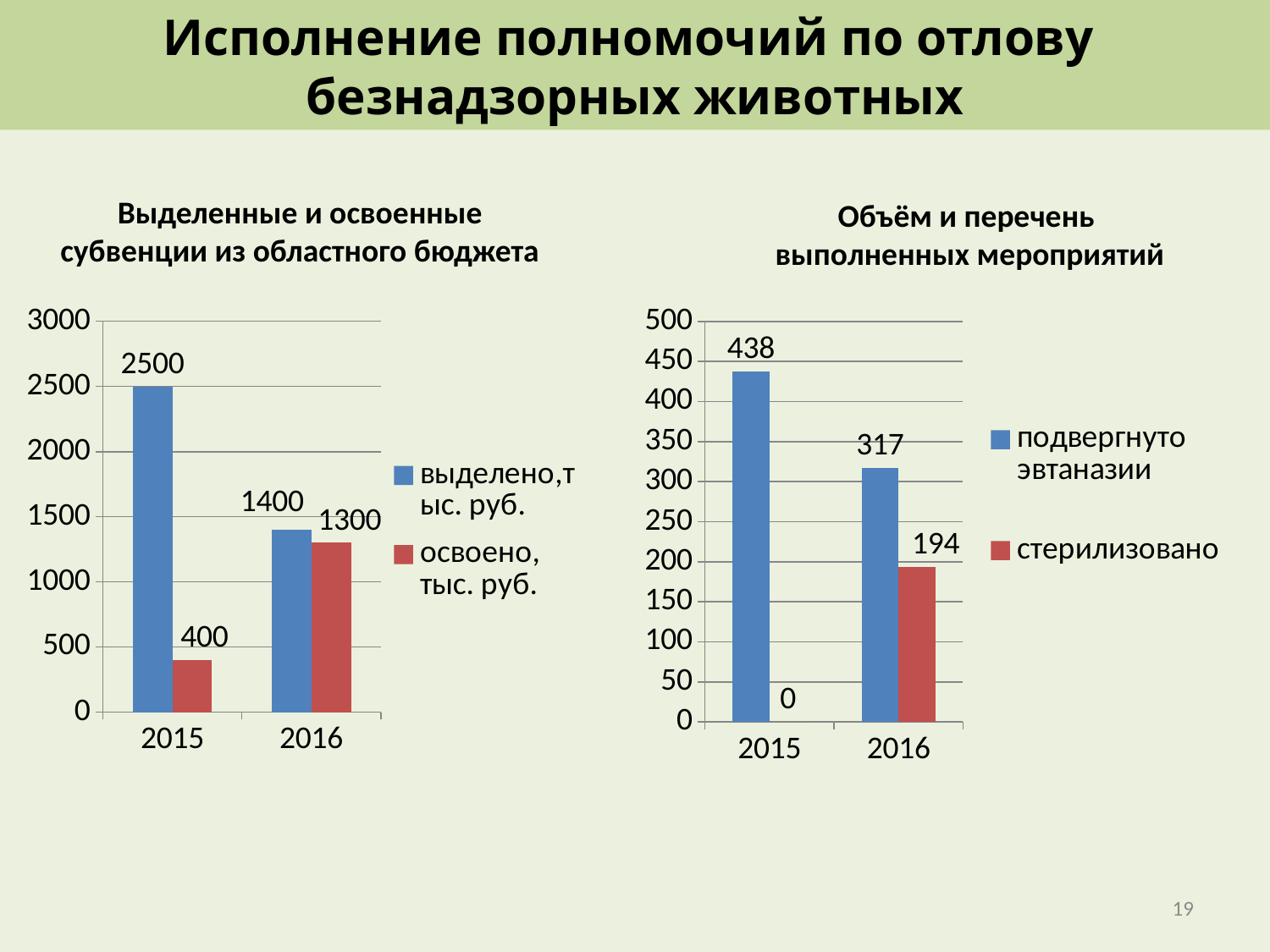
What type of chart is the right chart (Объём и перечень выполненных мероприятий)? bar chart In the left chart (Выделенные и освоенные субвенции из областного бюджета), how many series does the legend list? 2 In the right chart (Объём и перечень выполненных мероприятий), which series has the highest value overall? подвергнуто эвтаназии In the right chart (Объём и перечень выполненных мероприятий), what is the value of подвергнуто эвтаназии for 2015? 438 In the right chart (Объём и перечень выполненных мероприятий), what is the value of стерилизовано for 2016? 194 In the left chart (Выделенные и освоенные субвенции из областного бюджета), does the value of выделено rise or fall from 2015 to 2016? fall In the left chart (Выделенные и освоенные субвенции из областного бюджета), what is the difference between выделено and освоено in 2015? 2100 In the right chart (Объём и перечень выполненных мероприятий), what is the value of стерилизовано for 2015? 0 In the left chart (Выделенные и освоенные субвенции из областного бюджета), what is the value of освоено, тыс. руб. for 2016? 1300 In the right chart (Объём и перечень выполненных мероприятий), what is the difference between подвергнуто эвтаназии in 2015 and 2016? 121 In the left chart (Выделенные и освоенные субвенции из областного бюджета), which year has the higher value of освоено, тыс. руб.? 2016 In the left chart (Выделенные и освоенные субвенции из областного бюджета), what is the value of выделено, тыс. руб. for 2015? 2500